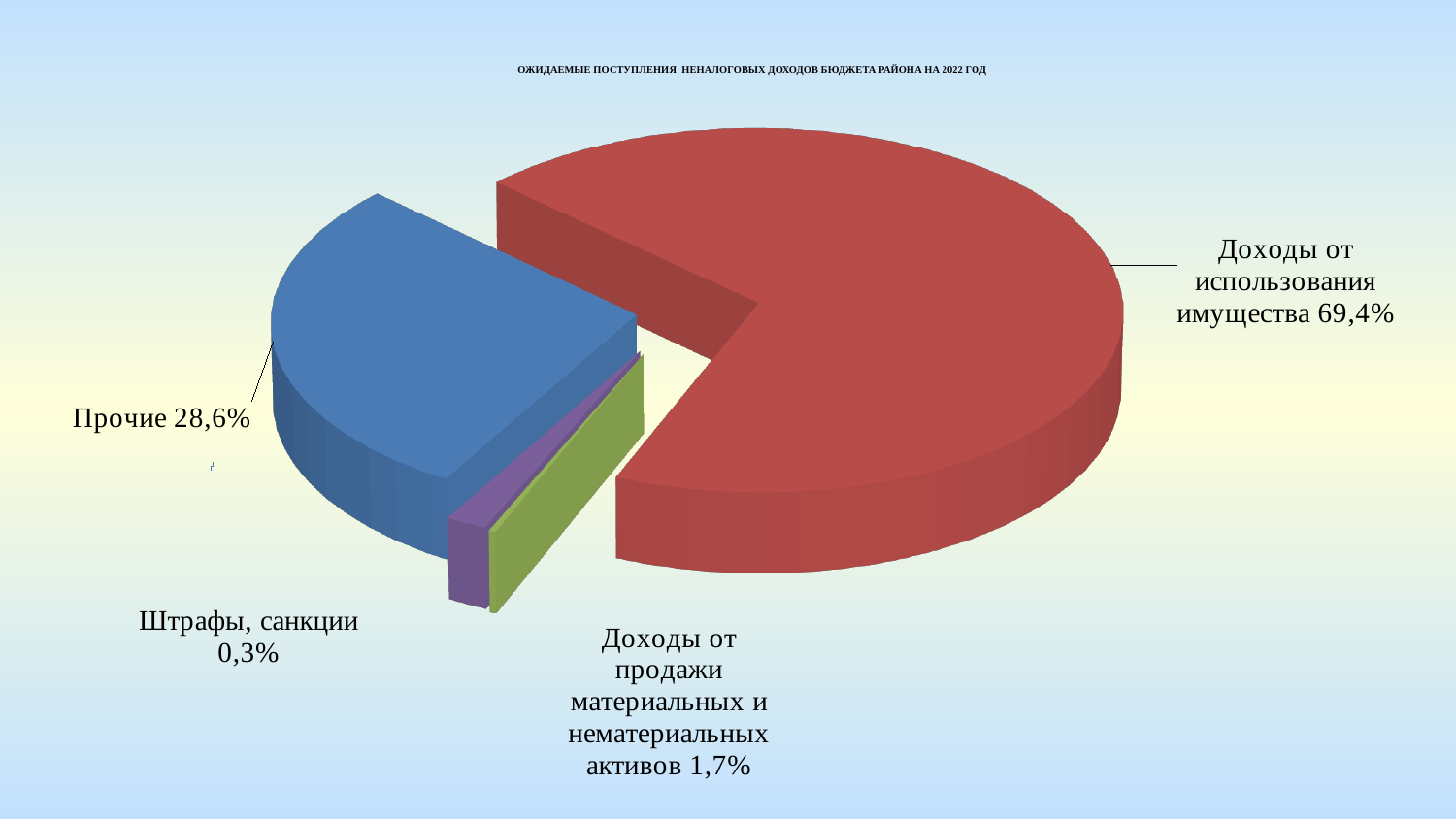
Какой тип диаграммы показан на слайде? Круговая диаграмма Какая категория имеет наименьшую долю? Штрафы, санкции Какова доля категории «Прочие»? 28,6% На сколько процентных пунктов доля «Доходы от использования имущества» больше доли «Прочие»? 40,8 Сколько категорий показано на диаграмме? 4 Каким цветом показана категория «Прочие»? Синим Как называется диаграмма на слайде? Ожидаемые поступления неналоговых доходов бюджета района на 2022 год Какая категория имеет наибольшую долю? Доходы от использования имущества Какова доля категории «Доходы от использования имущества»? 69,4% Какова доля категории «Штрафы, санкции»? 0,3% Какова доля категории «Доходы от продажи материальных и нематериальных активов»? 1,7% Что больше: доля «Прочие» или доля «Доходы от продажи материальных и нематериальных активов»? Прочие